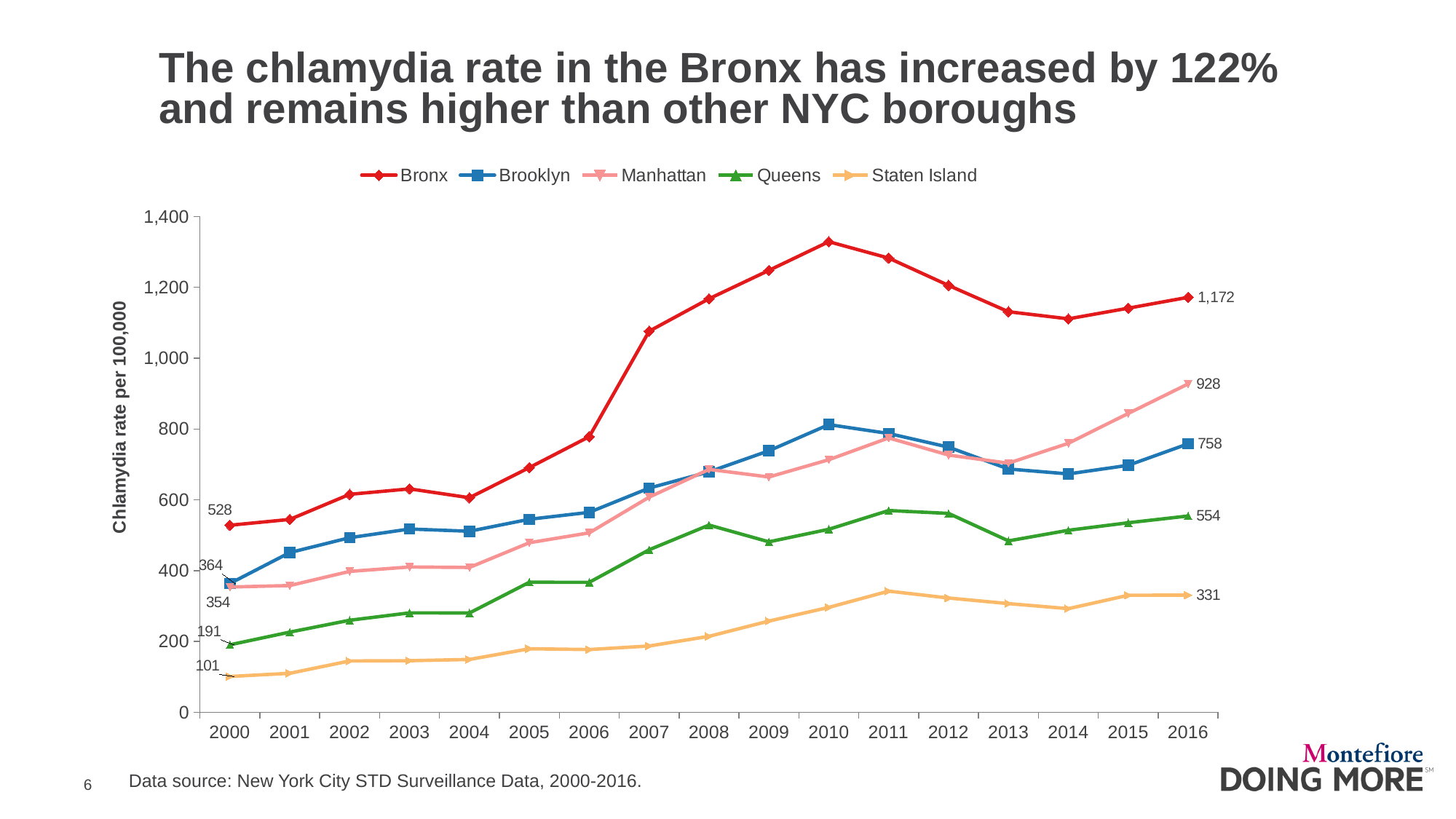
Which borough has the lowest chlamydia rate in 2000? Staten Island What is the chlamydia rate for Staten Island in 2000? 101 What kind of chart is shown on the slide? Line chart What is the chlamydia rate for the Bronx in 2016? 1,172 Which borough has the highest chlamydia rate in 2016? Bronx What is the chlamydia rate for Queens in 2000? 191 Is the Bronx rate in 2010 greater or less than 1,200? greater How many series does the legend list? 5 Which is larger in 2016, the Brooklyn rate or the Manhattan rate? Manhattan What is the chlamydia rate for Manhattan in 2016? 928 What is the difference between the Bronx rate in 2016 and the Bronx rate in 2000? 644 What is the label of the vertical axis? Chlamydia rate per 100,000